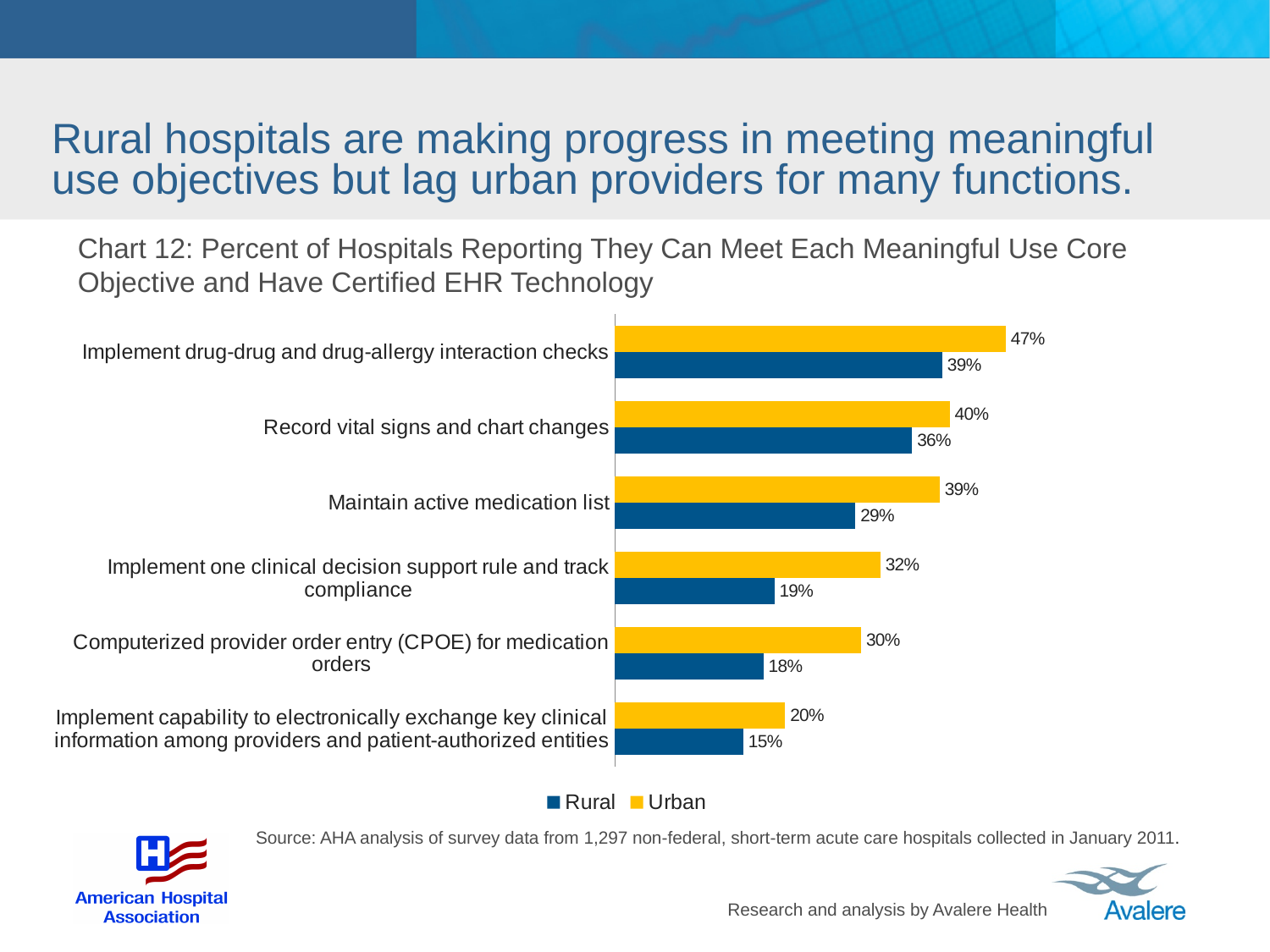
Which objective has the highest urban value? Implement drug-drug and drug-allergy interaction checks How many series does the legend list? 2 What is the difference between the urban and rural values for implementing one clinical decision support rule and tracking compliance? 13% What is the rural value for computerized provider order entry (CPOE) for medication orders? 18% Which colour represents the Rural series in the chart? Blue How many meaningful use core objectives are shown in the chart? 6 For recording vital signs and chart changes, which is larger: the rural value or the urban value? Urban What kind of chart is shown on the slide? Bar chart What percent of urban hospitals report they can implement drug-drug and drug-allergy interaction checks? 47% What percent of rural hospitals report they can maintain an active medication list? 29% What is the chart number given in the chart title? Chart 12 Which objective has the lowest rural value? Implement capability to electronically exchange key clinical information among providers and patient-authorized entities